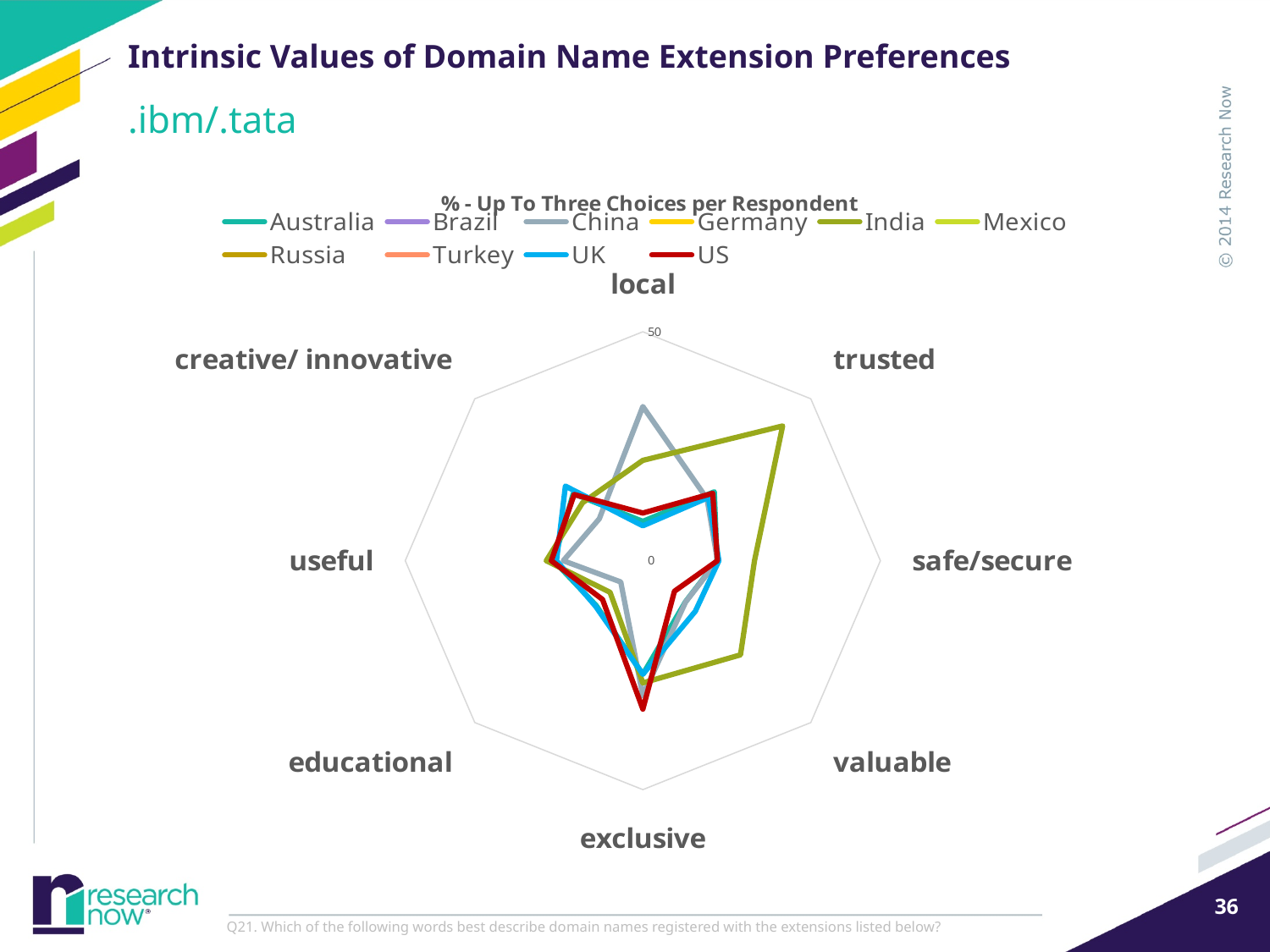
How many series does the chart legend list? 10 Which country has the highest value for trusted? India Which country has the highest value for exclusive? US Which domain name extensions does the chart refer to? .ibm/.tata What is the title of the chart? % - Up To Three Choices per Respondent What kind of chart is shown on the slide? Radar chart How many categories (axes) does the radar chart have? 8 Which category is positioned at the top of the radar chart? local Is the value for India on safe/secure greater or less than 50? less Is the value for China on local greater or less than 50? less Which country has the highest value for local? China What is the maximum value shown on the chart's axis scale? 50